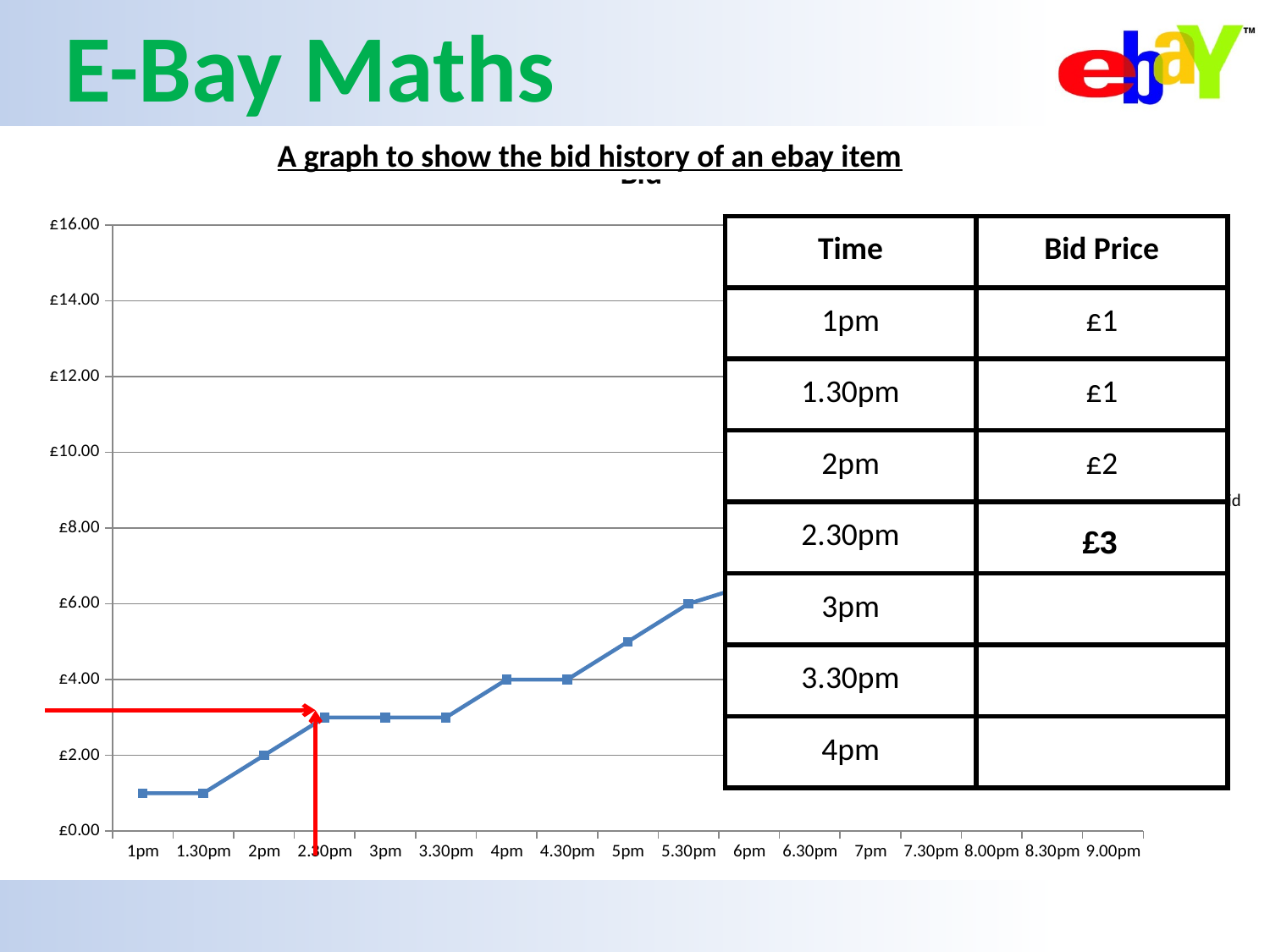
What kind of chart is shown on the slide? line chart What is the bid price at 1pm? £1 What is the bid price at 4pm? £4.00 What is the bid price at 2.30pm? £3 Is the bid price at 5pm greater or less than £4.00? greater Is the bid price at 3.30pm greater or less than £4.00? less What is the heading above the chart? A graph to show the bid history of an ebay item What is the bid price at 2pm? £2 What is the bid price at 5.30pm? £6.00 Do the bid prices generally rise or fall from 1pm to 5.30pm? rise What is the difference between the bid price at 2.30pm and at 1pm? £2 Which is higher, the bid price at 2pm or at 4pm? 4pm